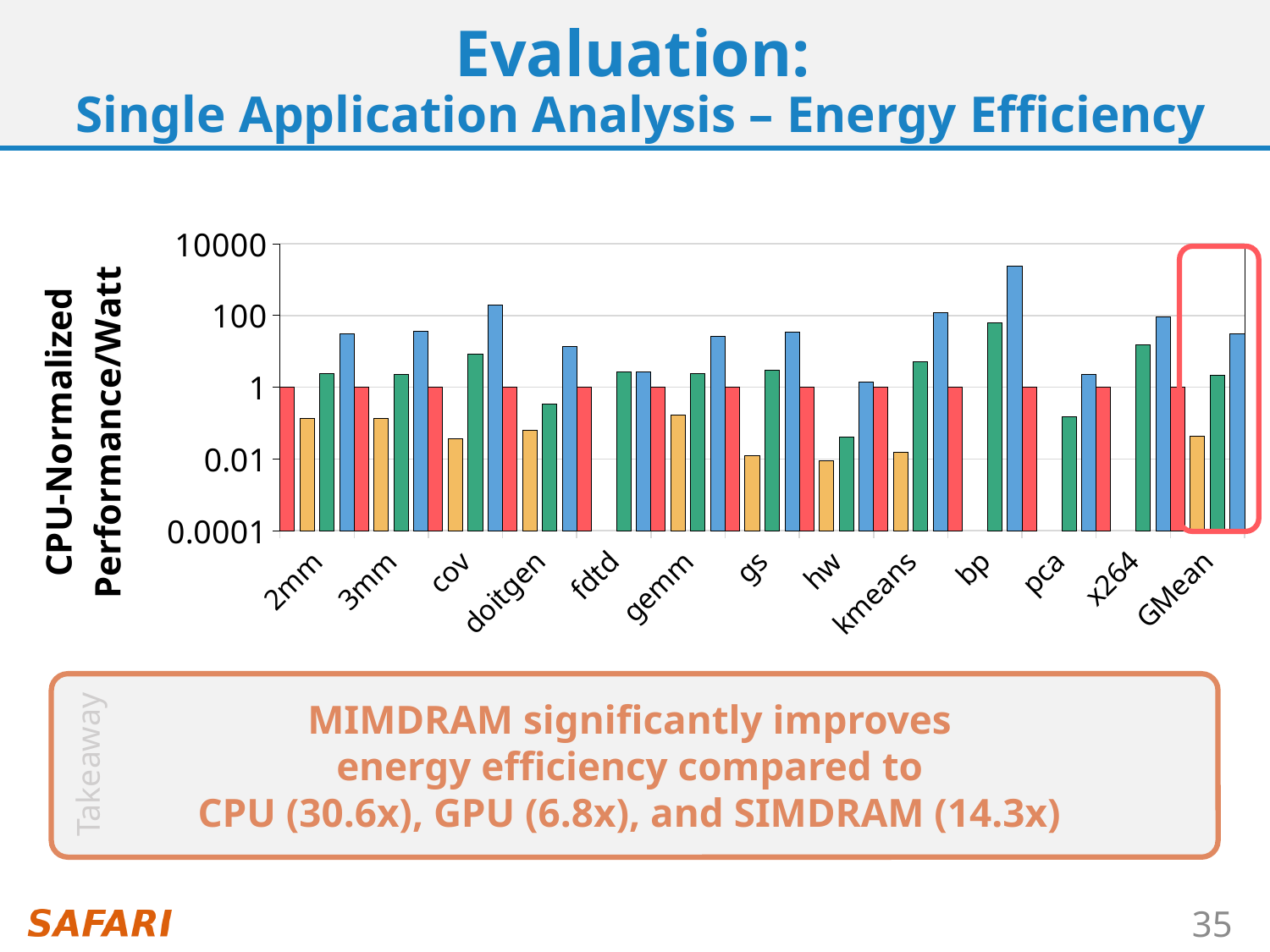
What kind of chart is shown on the slide? bar chart Is the value of the yellow bar for 2mm greater or less than 1? less What is the value of the red bar for GMean? 1 Is the value of the blue bar for bp greater or less than 100? greater How many categories are shown along the x axis of the chart? 13 Which category on the x axis is highlighted with a red box? GMean Which category has the highest blue bar? bp What is the label of the y axis of the chart? CPU-Normalized Performance/Watt What is the value of the red bar for 2mm? 1 Which is larger, the blue bar for bp or the blue bar for 2mm? bp Is the value of the blue bar for doitgen greater or less than 100? less